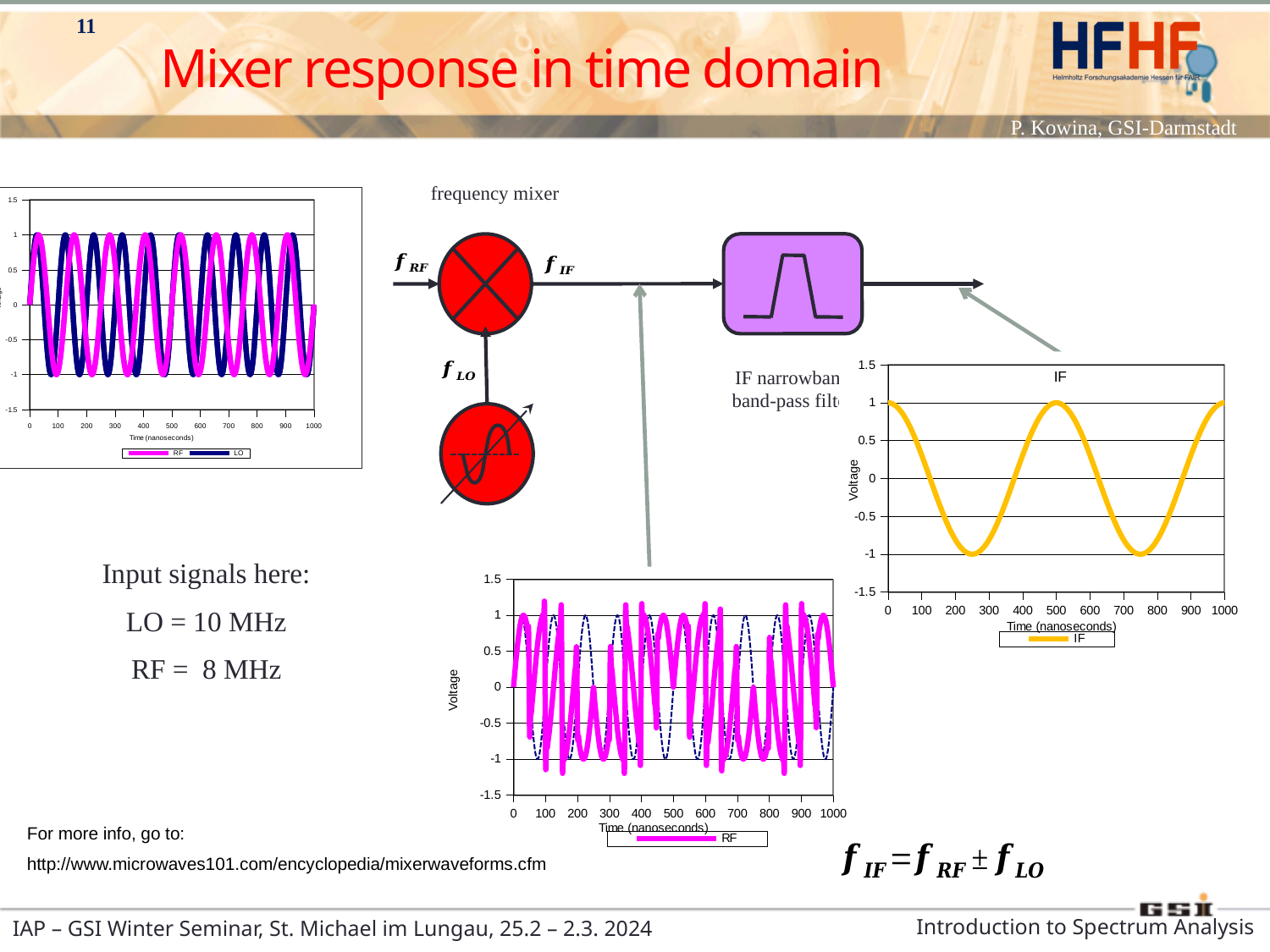
What is the x-axis label of the chart titled "IF"? Time (nanoseconds) How many series does the legend of the top-left chart list? 2 In the chart titled "IF", does the voltage rise or fall between 0 and 250 nanoseconds? fall In the chart titled "IF", what is the voltage at time 0 nanoseconds? 1 How many series does the legend of the bottom-middle chart list? 1 In the chart titled "IF", what is the voltage at time 1000 nanoseconds? 1 How many series does the legend of the chart titled "IF" list? 1 What kind of chart is the chart titled "IF" on the right of the slide? line chart In the chart titled "IF", is the voltage at 250 nanoseconds greater or less than -0.5? less In the chart titled "IF", what is the voltage at time 500 nanoseconds? 1 Which two series are listed in the legend of the top-left chart? RF and LO In the chart titled "IF", is the voltage at 750 nanoseconds greater or less than 0? less